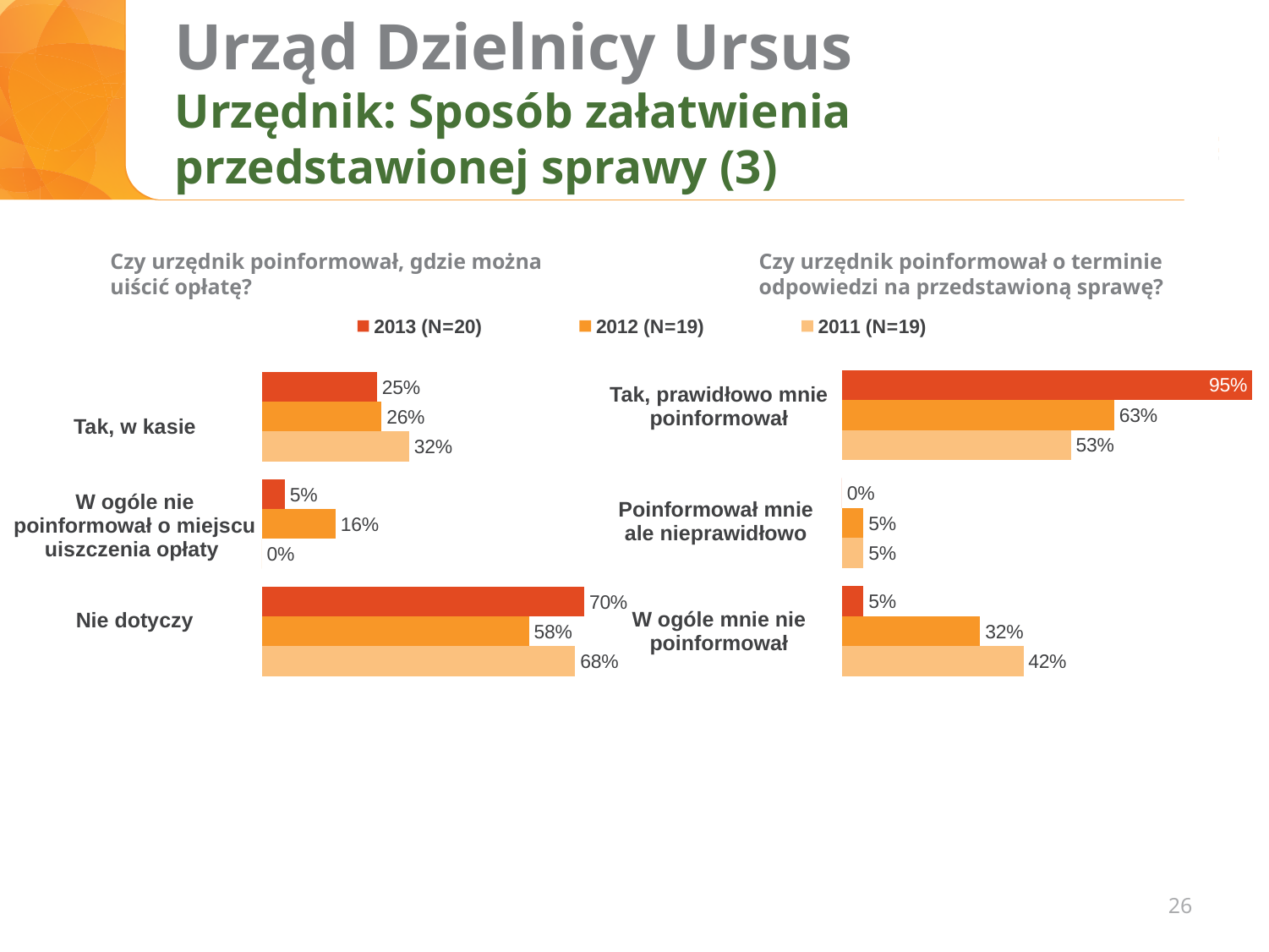
How many categories does the right chart ('Czy urzędnik poinformował o terminie odpowiedzi na przedstawioną sprawę?') show? 3 In the left chart ('Czy urzędnik poinformował, gdzie można uiścić opłatę?'), which is larger for 'Nie dotyczy': the 2013 (N=20) value or the 2011 (N=19) value? 2013 (N=20) In the right chart ('Czy urzędnik poinformował o terminie odpowiedzi na przedstawioną sprawę?'), which category has the lowest value for 2012 (N=19)? Poinformował mnie ale nieprawidłowo In the right chart ('Czy urzędnik poinformował o terminie odpowiedzi na przedstawioną sprawę?'), what is the value for 'Tak, prawidłowo mnie poinformował' in 2013 (N=20)? 95% What kind of chart is the left chart ('Czy urzędnik poinformował, gdzie można uiścić opłatę?')? Bar chart In the left chart ('Czy urzędnik poinformował, gdzie można uiścić opłatę?'), what is the value for 'Tak, w kasie' in 2013 (N=20)? 25% In the left chart ('Czy urzędnik poinformował, gdzie można uiścić opłatę?'), which category has the highest value for 2013 (N=20)? Nie dotyczy In the left chart ('Czy urzędnik poinformował, gdzie można uiścić opłatę?'), what is the value for 'Nie dotyczy' in 2012 (N=19)? 58% In the right chart ('Czy urzędnik poinformował o terminie odpowiedzi na przedstawioną sprawę?'), what is the value for 'W ogóle mnie nie poinformował' in 2011 (N=19)? 42% In the left chart ('Czy urzędnik poinformował, gdzie można uiścić opłatę?'), what is the difference between the 2012 (N=19) and 2013 (N=20) values for 'W ogóle nie poinformował o miejscu uiszczenia opłaty'? 11 percentage points How many series does the legend list? 3 In the right chart ('Czy urzędnik poinformował o terminie odpowiedzi na przedstawioną sprawę?'), what is the difference between the 2013 (N=20) and 2011 (N=19) values for 'Tak, prawidłowo mnie poinformował'? 42 percentage points